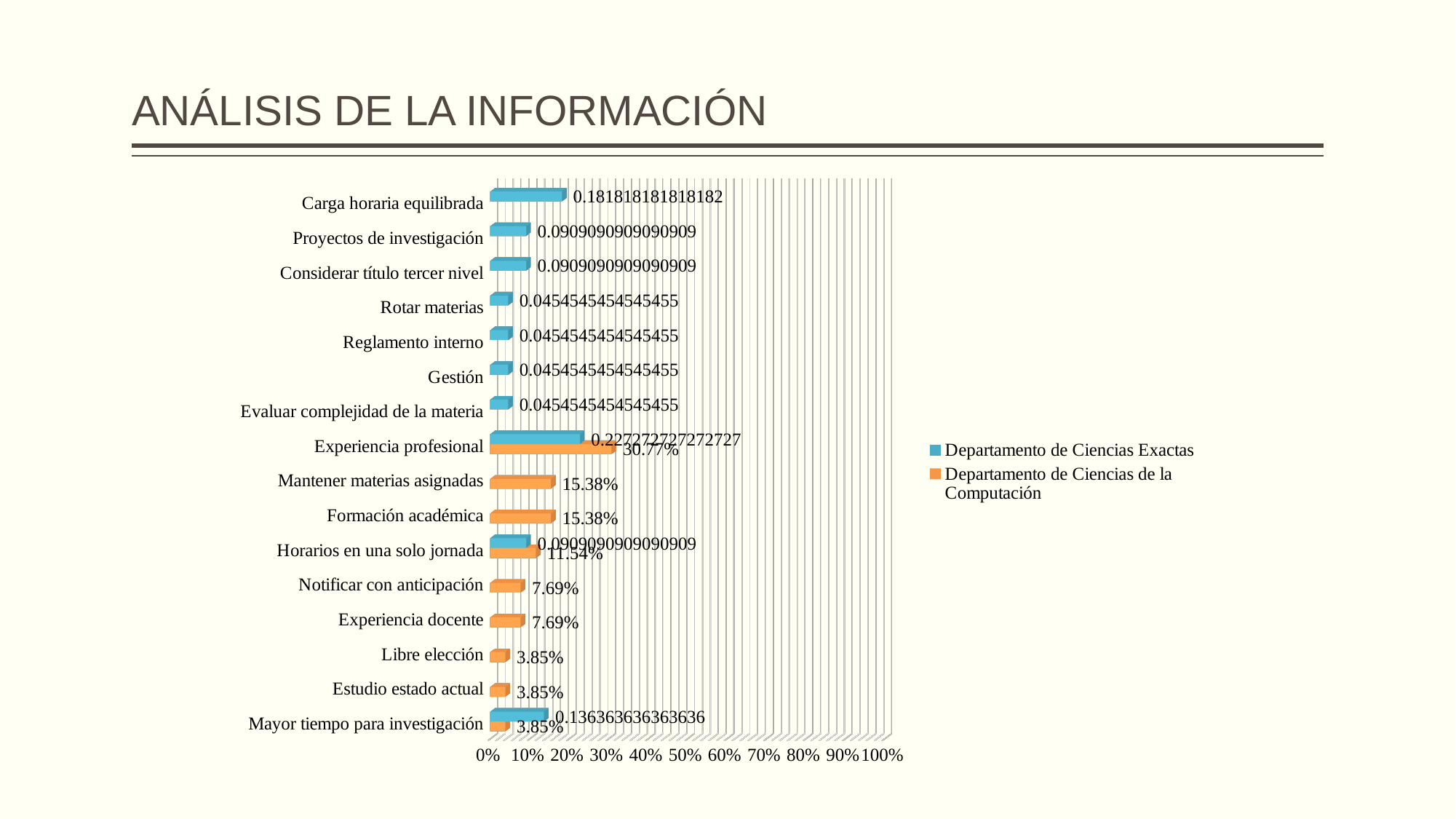
How many series does the legend list? 2 For Departamento de Ciencias de la Computación, which is larger: Mantener materias asignadas or Horarios en una solo jornada? Mantener materias asignadas How many categories are shown on the vertical axis of the chart? 16 Which category has the highest value for Departamento de Ciencias Exactas? Experiencia profesional What is the value for Departamento de Ciencias de la Computación for Experiencia profesional? 30.77% What is the value for Departamento de Ciencias Exactas for Mayor tiempo para investigación? 0.136363636363636 Is the Departamento de Ciencias de la Computación value for Experiencia profesional greater or less than 20%? greater What is the value for Departamento de Ciencias Exactas for Carga horaria equilibrada? 0.181818181818182 What kind of chart is shown on the slide? Bar chart Which category has the highest value for Departamento de Ciencias de la Computación? Experiencia profesional What is the difference between the Departamento de Ciencias de la Computación values for Experiencia profesional and Formación académica? 15.39% What is the value for Departamento de Ciencias de la Computación for Notificar con anticipación? 7.69%